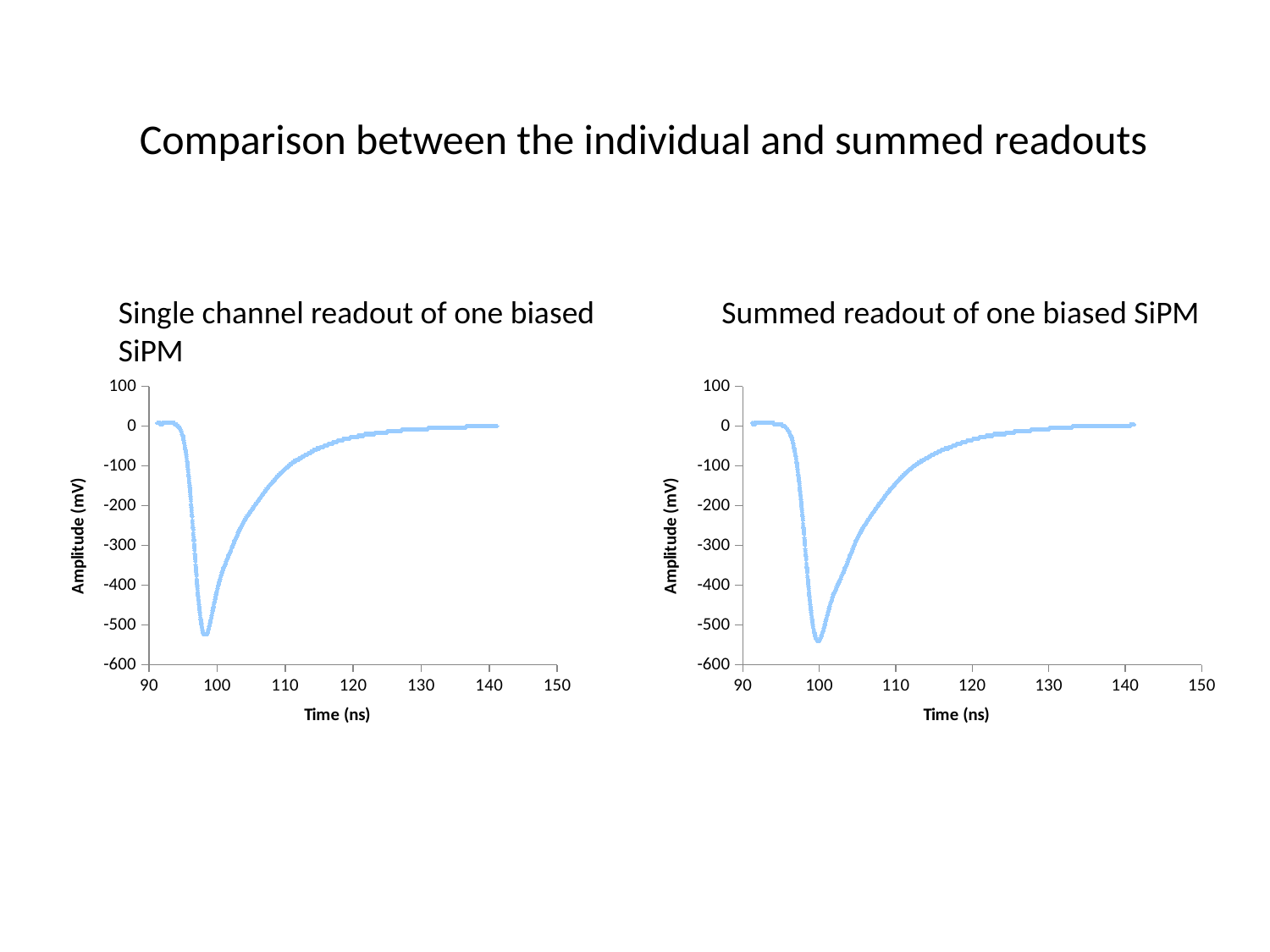
In the 'Single channel readout of one biased SiPM' chart, what is the label of the y axis? Amplitude (mV) In the 'Single channel readout of one biased SiPM' chart, is the lowest amplitude value greater or less than -500? less In the 'Summed readout of one biased SiPM' chart, is the lowest amplitude value greater or less than -500? less In the 'Summed readout of one biased SiPM' chart, after the minimum near 100 ns, do the amplitude values rise or fall as time increases? rise In the 'Summed readout of one biased SiPM' chart, what is the label of the x axis? Time (ns) How many charts are shown on the slide? 2 What is the highest value shown on the y axis of the 'Single channel readout of one biased SiPM' chart? 100 In the 'Single channel readout of one biased SiPM' chart, is the amplitude at 120 ns greater or less than -100? greater